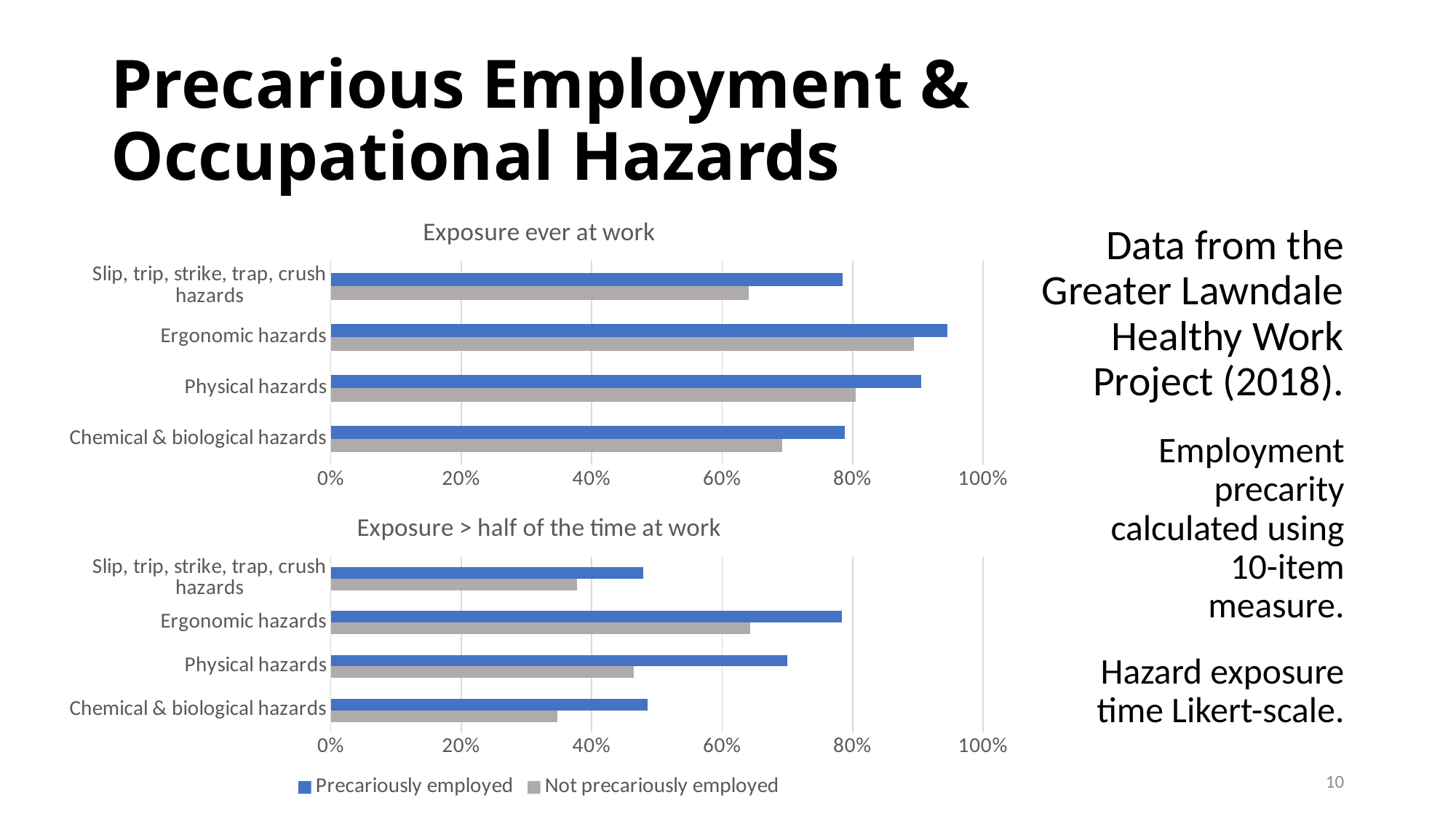
What type of chart is the 'Exposure ever at work' chart? Bar chart In the 'Exposure > half of the time at work' chart, is the Precariously employed value for Ergonomic hazards greater or less than 60%? greater How many hazard categories are shown in the 'Exposure > half of the time at work' chart? 4 In the 'Exposure ever at work' chart, which hazard category has the highest value for Precariously employed? Ergonomic hazards How many series does the legend list for the charts on the slide? 2 In the 'Exposure ever at work' chart, is the Precariously employed value for Ergonomic hazards greater or less than 80%? greater In the 'Exposure > half of the time at work' chart, which hazard category has the highest value for Not precariously employed? Ergonomic hazards In the 'Exposure > half of the time at work' chart, which is larger for Physical hazards: Precariously employed or Not precariously employed? Precariously employed In the 'Exposure ever at work' chart, which is larger for Physical hazards: Precariously employed or Not precariously employed? Precariously employed What colour represents the Not precariously employed series in the charts? Grey In the 'Exposure ever at work' chart, is the Not precariously employed value for Slip, trip, strike, trap, crush hazards greater or less than 80%? less